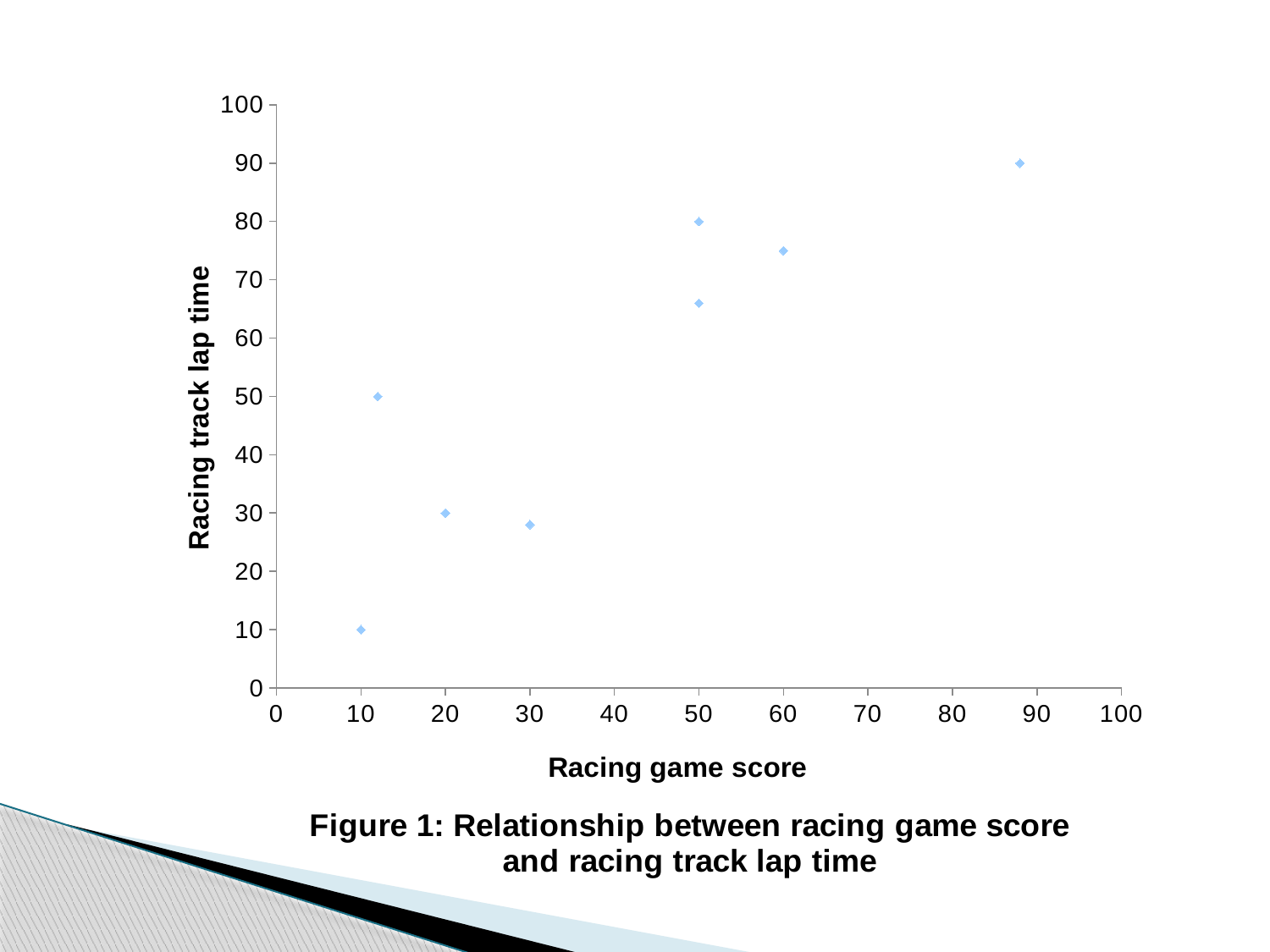
What is the title of the x axis? Racing game score How many data points are plotted on the chart? 8 What is the lowest racing track lap time plotted on the chart? 10 Overall, does racing track lap time rise or fall as racing game score increases? Rises Is the racing track lap time for the point at a racing game score of 60 greater or less than 70? greater What is the racing track lap time for the point at a racing game score of 20? 30 What is the racing track lap time for the point at a racing game score of 10? 10 What is the highest racing track lap time plotted on the chart? 90 How many points are plotted at a racing game score of 50? 2 What is the title of the y axis? Racing track lap time Which point has the higher racing track lap time: the one at a racing game score of 60 or the one at a racing game score of 20? The one at a racing game score of 60 What kind of chart is shown on the slide? Scatter plot